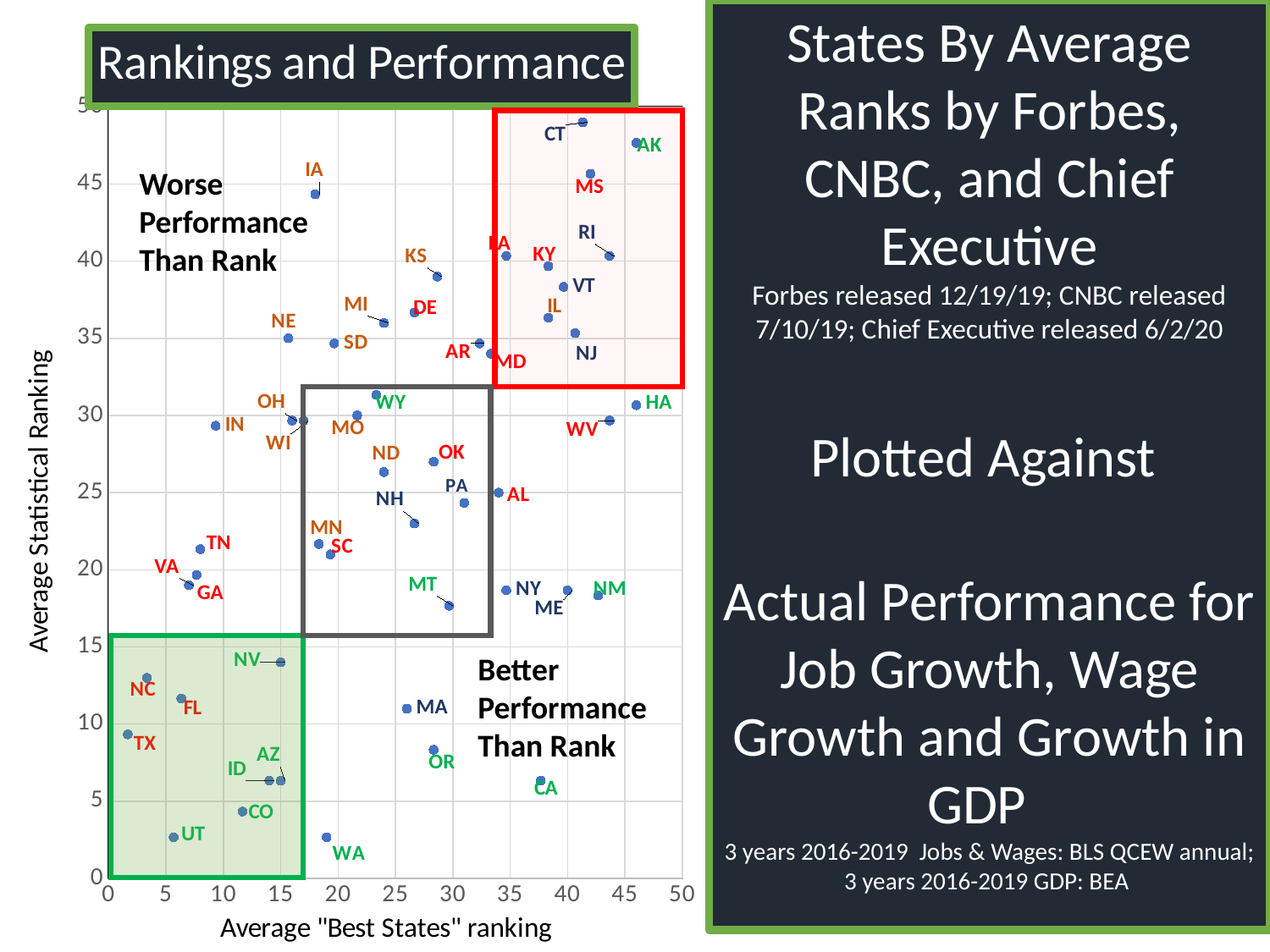
Which state has the highest Average Statistical Ranking on the chart? CT Is the Average Statistical Ranking for KS greater or less than 35? greater Is the Average Statistical Ranking for IA greater or less than 40? greater What is the title of the chart? Rankings and Performance Is the Average Statistical Ranking for CT greater or less than 45? greater Which state has a higher Average Statistical Ranking, CT or WA? CT What kind of chart is shown on the slide? scatter plot What is the label of the x axis of the chart? Average "Best States" ranking